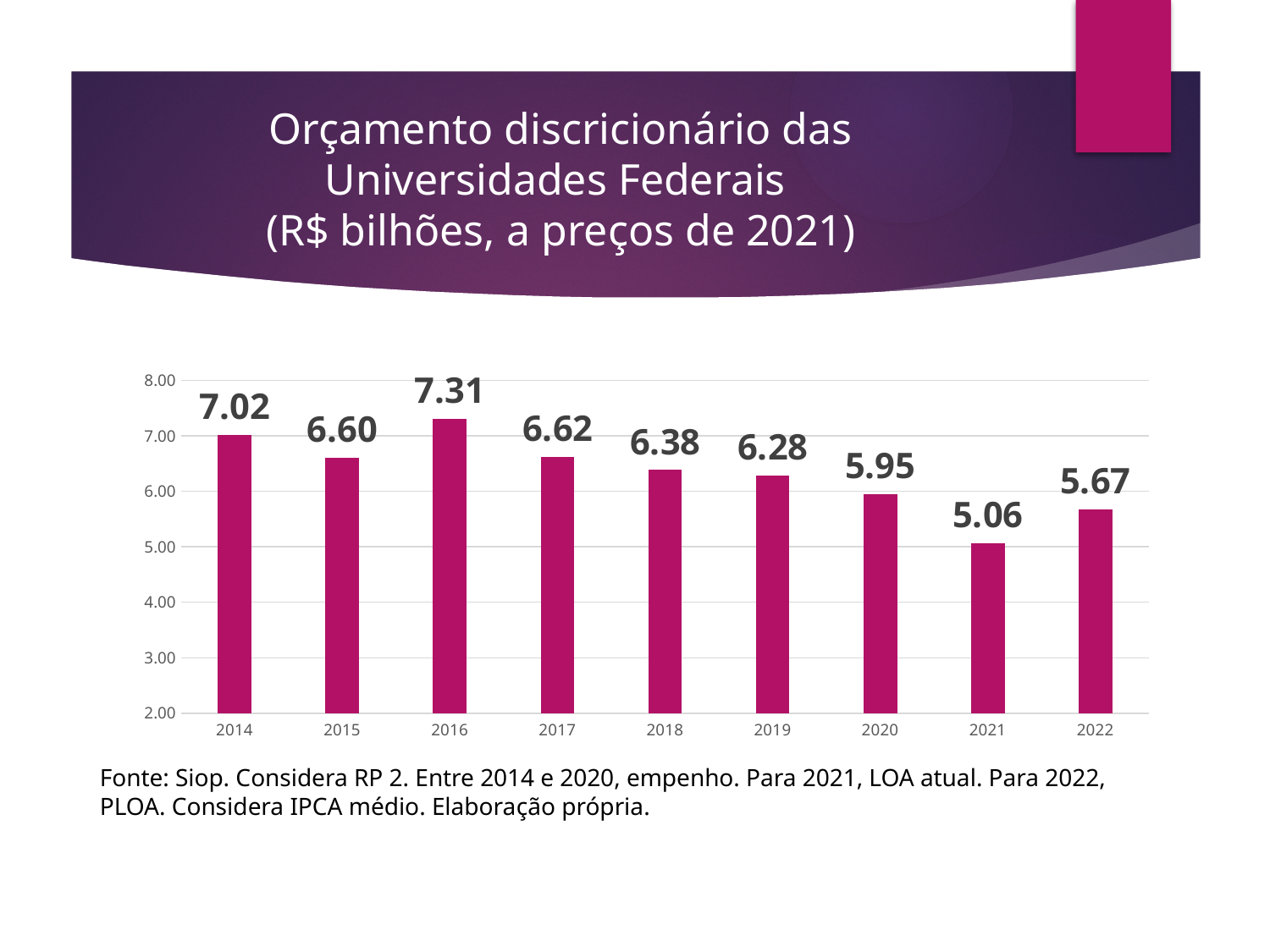
What is the difference between the values for 2014 and 2022? 1.35 What is the difference between the values for 2016 and 2021? 2.25 Which is larger, the value for 2017 or the value for 2018? 2017 Which year has the highest value? 2016 What is the value for 2021? 5.06 How many years are shown on the x axis? 9 What kind of chart is shown on the slide? bar chart What is the value for 2016? 7.31 Which year has the lowest value? 2021 Do the values generally rise or fall from 2016 to 2021? fall What is the value for 2019? 6.28 Is the value for 2020 greater or less than 6.00? less